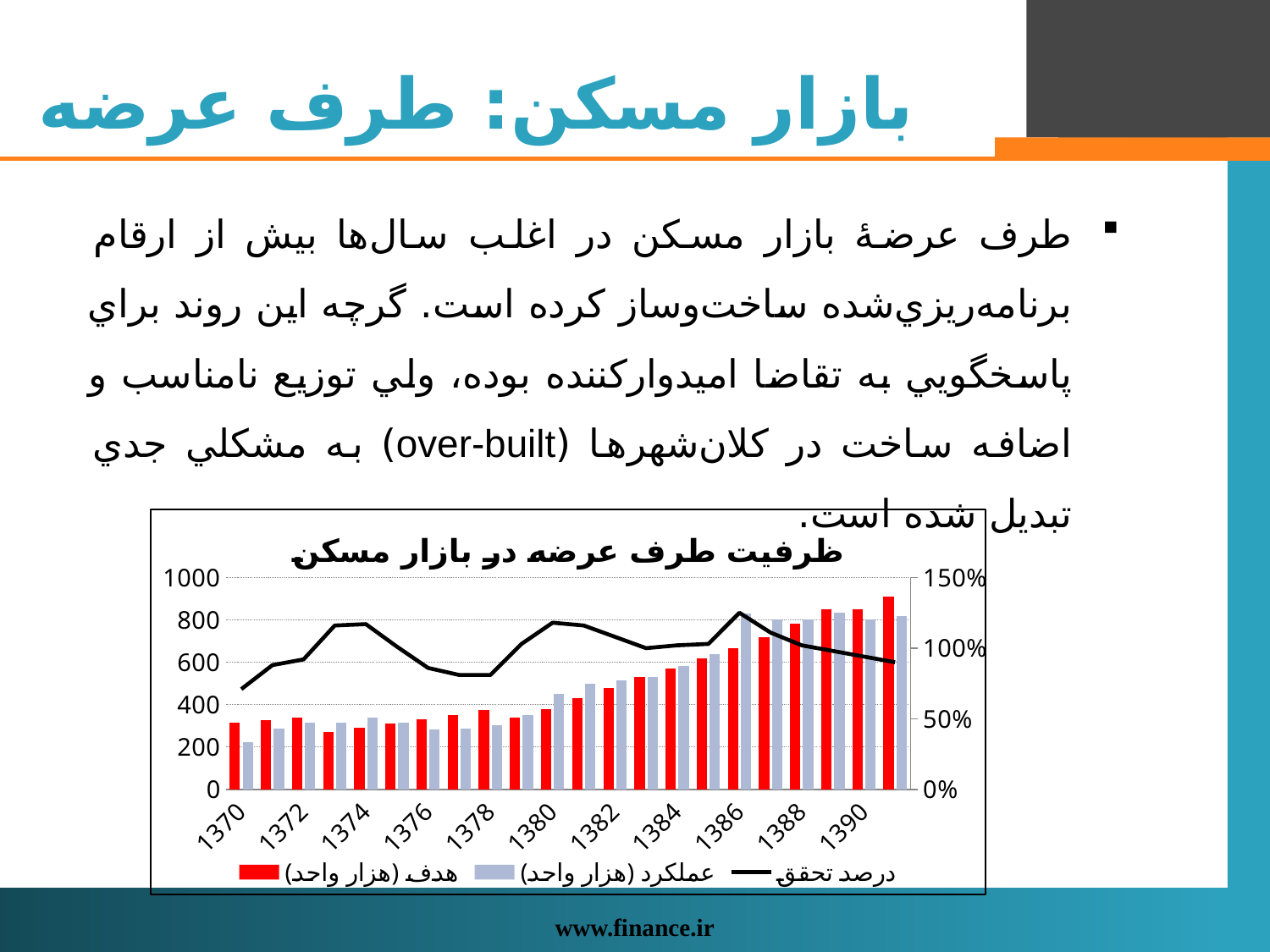
Is the value of عملکرد (هزار واحد) for 1370 greater or less than 400? less Is the value of درصد تحقق for 1386 greater or less than 100%? greater Do the هدف (هزار واحد) bars generally rise or fall from 1370 to 1390? rise Is the value of هدف (هزار واحد) for 1390 greater or less than 800? greater What kind of chart is shown on the slide? Bar chart with a line series How many years are shown along the x axis of the chart? 22 What is the title of the chart? ظرفیت طرف عرضه در بازار مسکن How many series does the chart legend list? 3 Which series is drawn as a black line in the chart? درصد تحقق Which is larger in 1390, هدف (هزار واحد) or عملکرد (هزار واحد)? هدف (هزار واحد) In which year is the هدف (هزار واحد) bar the highest? 1391